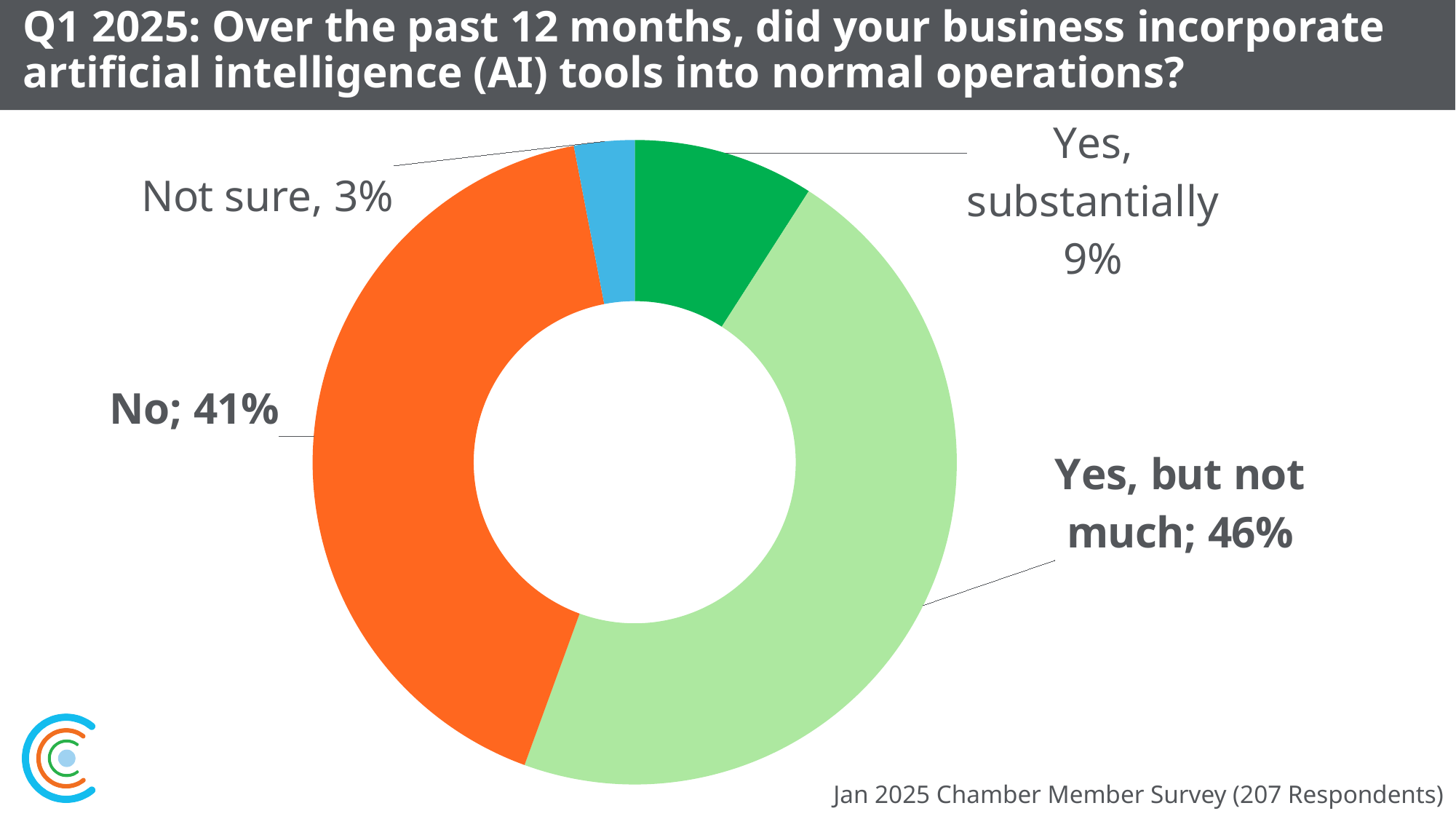
Which is larger: the share for "Yes, substantially" or the share for "Not sure"? Yes, substantially What colour is the "No" slice? Orange How many response categories are shown in the chart? 4 What is the difference in percentage points between "No" and "Yes, substantially"? 32 What share of respondents answered "Yes, substantially"? 9% Which response has the largest share of the pie? Yes, but not much What share of respondents answered "No"? 41% What share of respondents answered "Yes, but not much"? 46% Which response has the smallest share of the pie? Not sure What share of respondents answered "Not sure"? 3% What is the difference in percentage points between "Yes, but not much" and "No"? 5 What kind of chart is shown on the slide? Pie chart (doughnut)